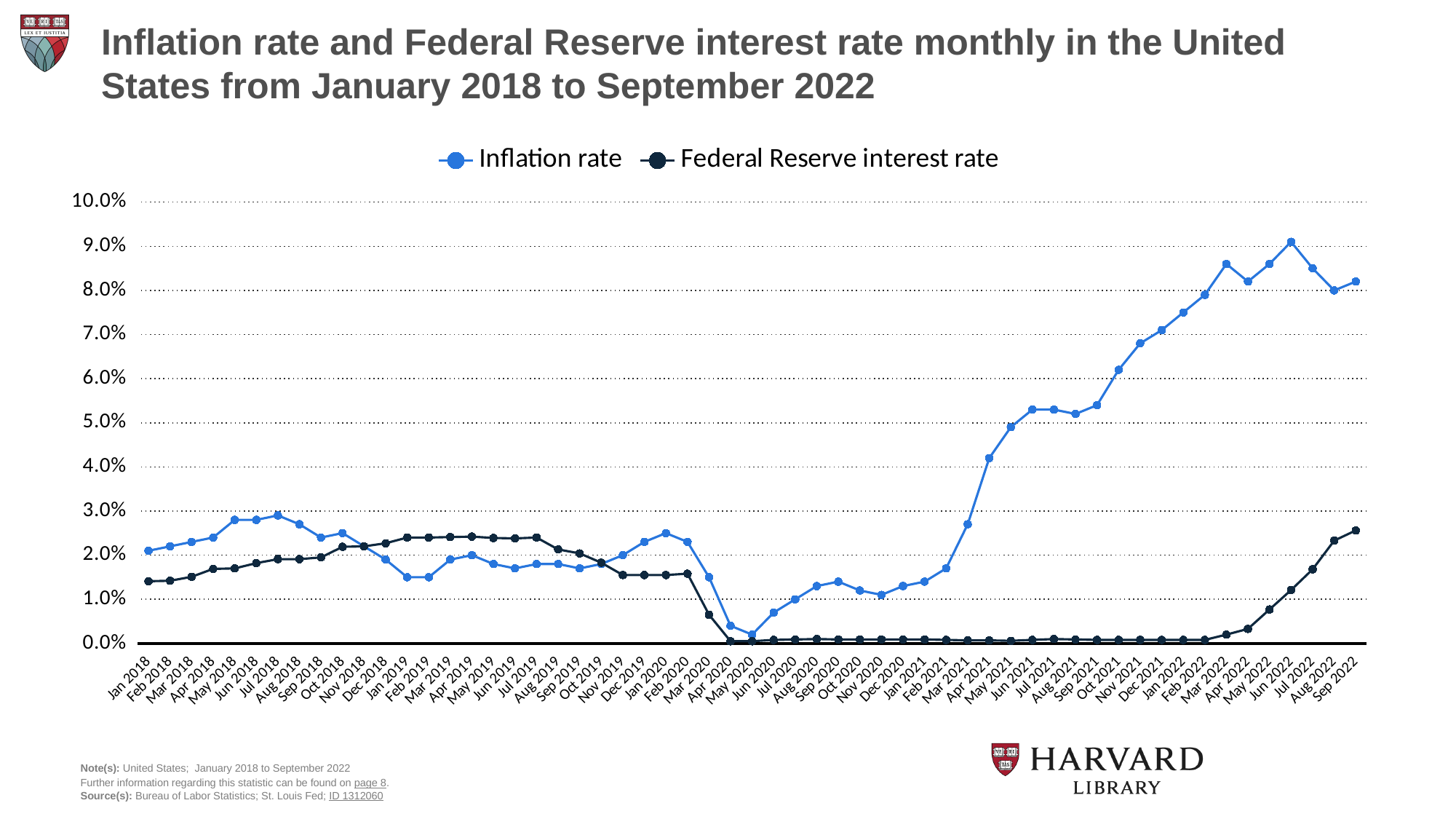
In which month is the Inflation rate at its lowest? May 2020 Is the Inflation rate for May 2020 greater or less than 1.0%? less In Sep 2022, which is higher: the Inflation rate or the Federal Reserve interest rate? Inflation rate How many series does the legend list? 2 What kind of chart is shown on the slide? Line chart Is the Inflation rate for Jun 2022 greater or less than 8.0%? greater In Mar 2019, which is higher: the Inflation rate or the Federal Reserve interest rate? Federal Reserve interest rate Is the Federal Reserve interest rate for Sep 2022 greater or less than 2.0%? greater Does the Inflation rate generally rise or fall from Jan 2021 to Jun 2022? rise How many monthly data points are plotted for each series? 57 In which month does the Inflation rate reach its highest value? Jun 2022